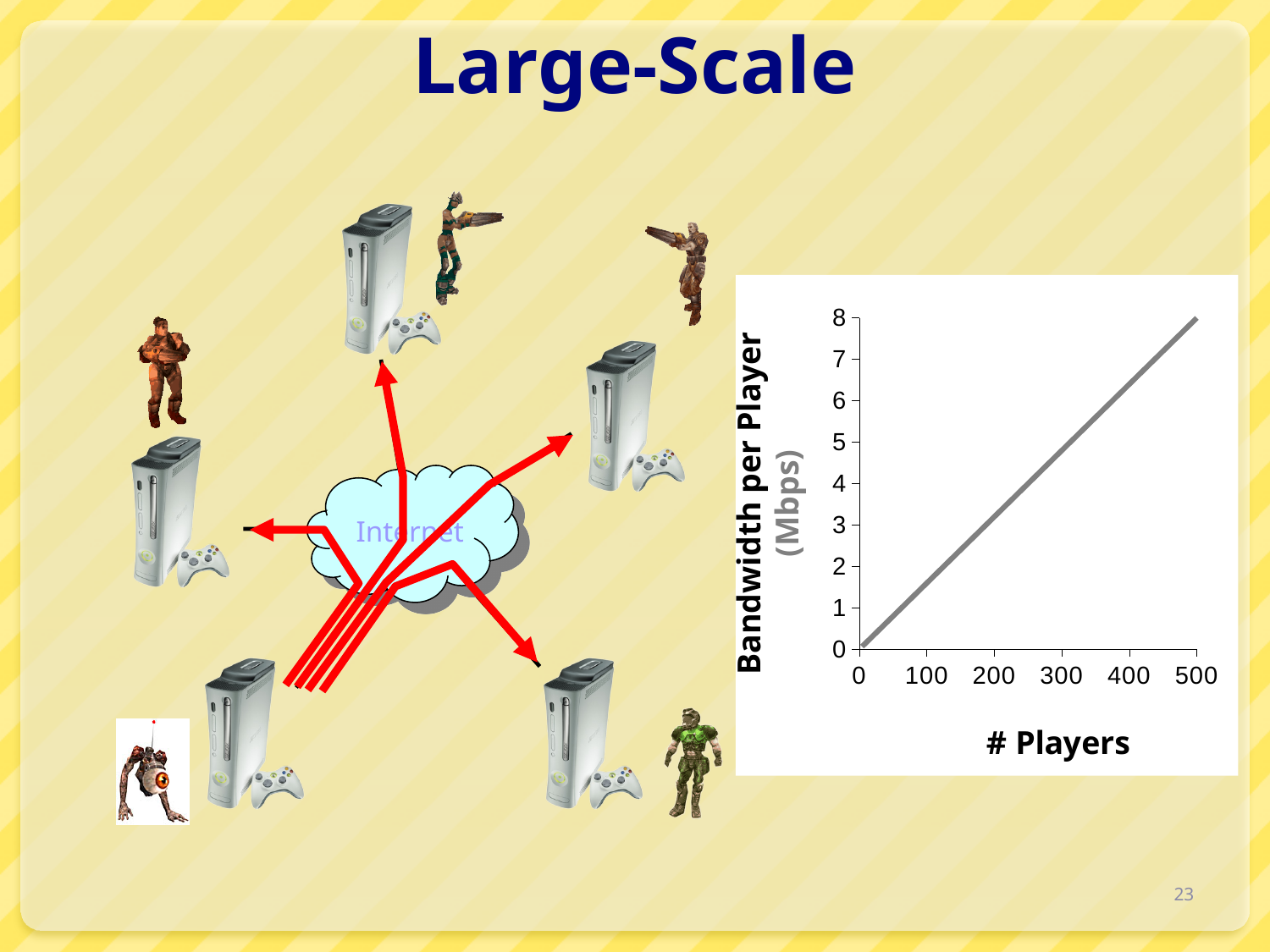
Does bandwidth per player rise or fall as the number of players increases? rises Which has the higher bandwidth per player, 200 players or 400 players? 400 players What is the label of the y axis? Bandwidth per Player (Mbps) Is the bandwidth per player at 100 players greater or less than 2? less Is the bandwidth per player at 200 players greater or less than 4? less What is the highest value shown on the y axis? 8 What is the bandwidth per player at 500 players? 8 Is the bandwidth per player at 300 players greater or less than 4? greater What kind of chart is shown on the slide? line chart What is the label of the x axis? # Players